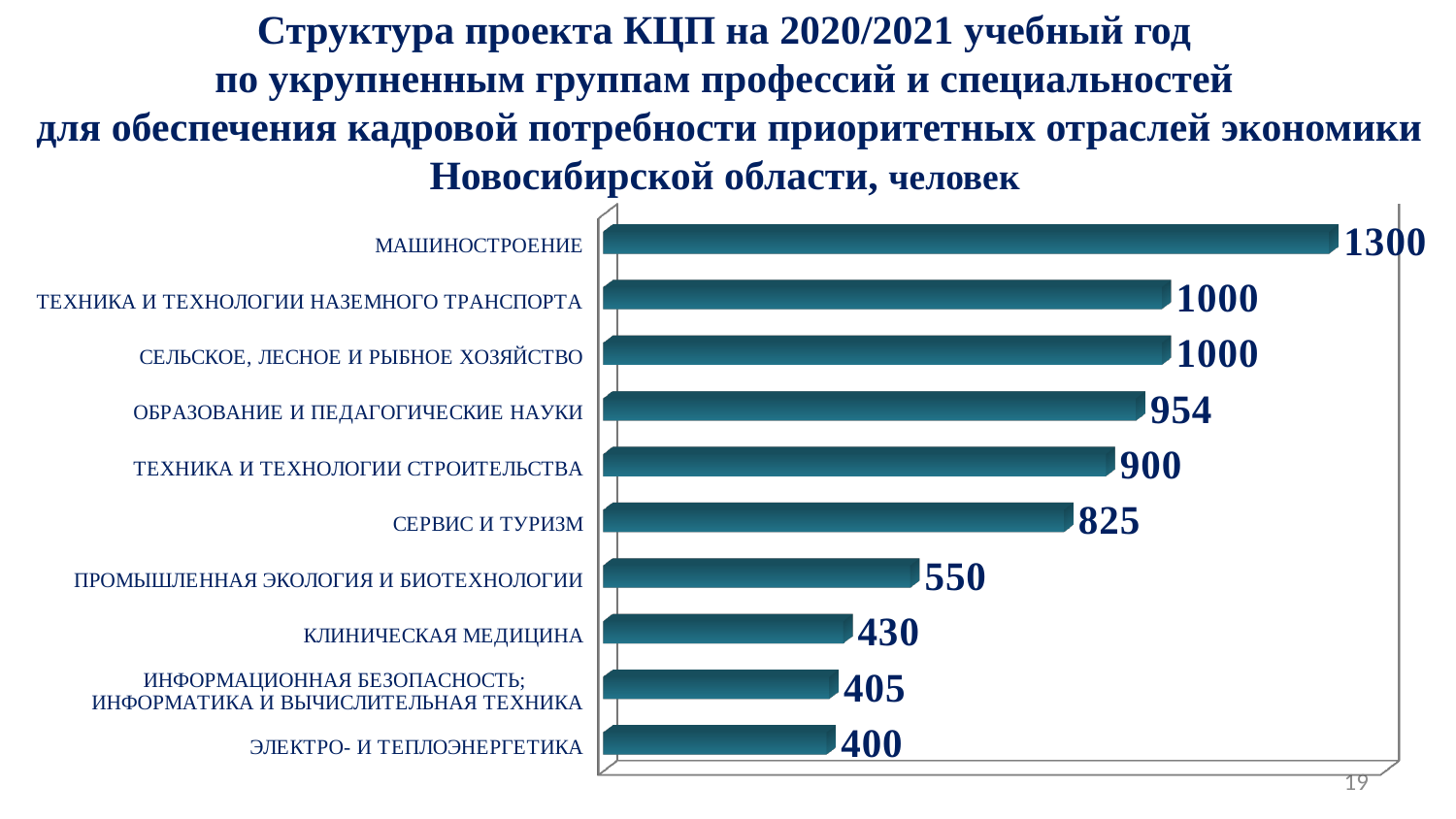
Which category has the highest value? МАШИНОСТРОЕНИЕ What is the difference between the values for ПРОМЫШЛЕННАЯ ЭКОЛОГИЯ И БИОТЕХНОЛОГИИ and КЛИНИЧЕСКАЯ МЕДИЦИНА? 120 What kind of chart is shown on the slide? Bar chart How many categories are shown in the chart? 10 What is the value for ОБРАЗОВАНИЕ И ПЕДАГОГИЧЕСКИЕ НАУКИ? 954 Which category has the lowest value? ЭЛЕКТРО- И ТЕПЛОЭНЕРГЕТИКА Which is larger: the value for СЕРВИС И ТУРИЗМ or the value for ТЕХНИКА И ТЕХНОЛОГИИ СТРОИТЕЛЬСТВА? ТЕХНИКА И ТЕХНОЛОГИИ СТРОИТЕЛЬСТВА What is the value for КЛИНИЧЕСКАЯ МЕДИЦИНА? 430 Which two categories share the value 1000? ТЕХНИКА И ТЕХНОЛОГИИ НАЗЕМНОГО ТРАНСПОРТА and СЕЛЬСКОЕ, ЛЕСНОЕ И РЫБНОЕ ХОЗЯЙСТВО What is the value for МАШИНОСТРОЕНИЕ? 1300 What is the difference between the values for МАШИНОСТРОЕНИЕ and ТЕХНИКА И ТЕХНОЛОГИИ СТРОИТЕЛЬСТВА? 400 What is the value for СЕРВИС И ТУРИЗМ? 825